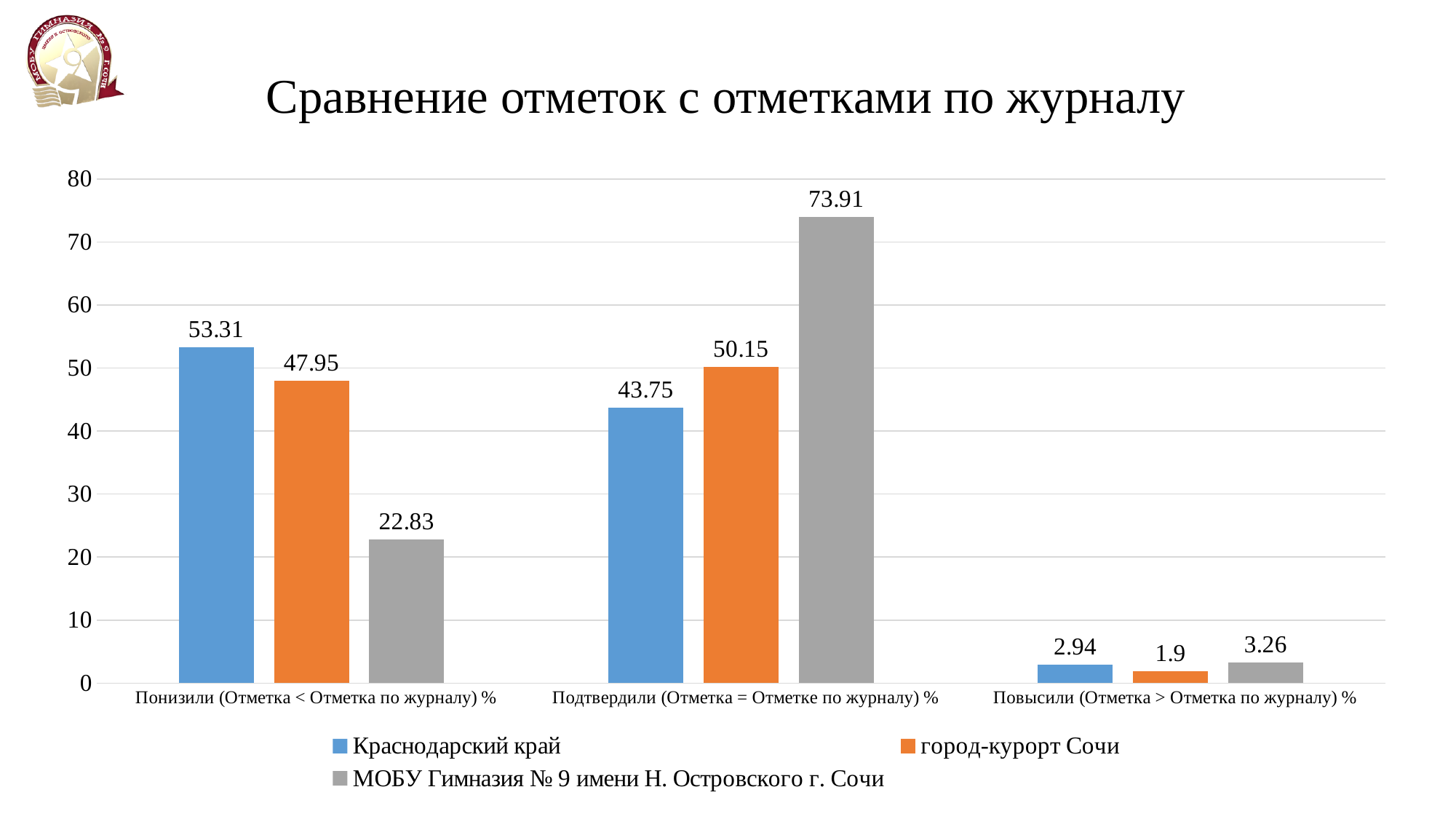
Which series has the highest value in the Подтвердили (Отметка = Отметке по журналу) % category? МОБУ Гимназия № 9 имени Н. Островского г. Сочи Is the value for МОБУ Гимназия № 9 имени Н. Островского г. Сочи in the Понизили (Отметка < Отметка по журналу) % category greater or less than 30? less What is the value for город-курорт Сочи in the Повысили (Отметка > Отметка по журналу) % category? 1.9 What is the value for Краснодарский край in the Понизили (Отметка < Отметка по журналу) % category? 53.31 What kind of chart is shown on the slide? bar chart What is the difference between the Краснодарский край and город-курорт Сочи values in the Понизили (Отметка < Отметка по журналу) % category? 5.36 What is the value for МОБУ Гимназия № 9 имени Н. Островского г. Сочи in the Подтвердили (Отметка = Отметке по журналу) % category? 73.91 Which is larger in the Подтвердили (Отметка = Отметке по журналу) % category: Краснодарский край or город-курорт Сочи? город-курорт Сочи Which series has the lowest value in the Повысили (Отметка > Отметка по журналу) % category? город-курорт Сочи How many categories are shown on the x axis? 3 How many series does the legend list? 3 What is the title of the chart? Сравнение отметок с отметками по журналу